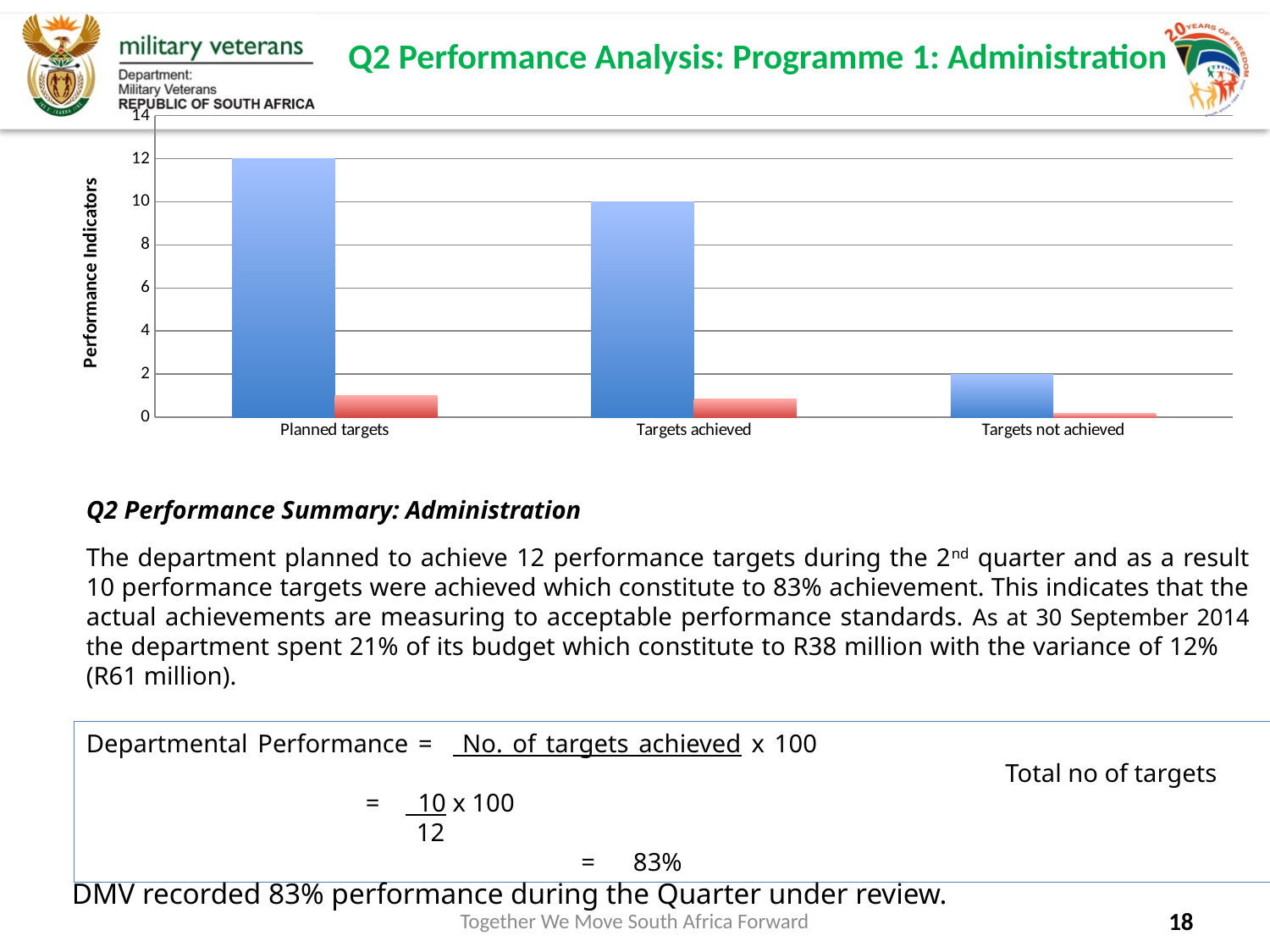
Which is larger, the blue bar for Targets achieved or the blue bar for Targets not achieved? Targets achieved What is the value of the blue bar for Targets not achieved? 2 How many categories are shown on the x axis of the chart? 3 Do the blue bars rise or fall from left to right across the categories? fall Is the red bar for Planned targets greater or less than 2? less What is the value of the blue bar for Targets achieved? 10 What type of chart is shown on the slide? bar chart What is the label on the vertical axis of the chart? Performance Indicators What is the value of the blue bar for Planned targets? 12 What is the difference between the blue bars for Planned targets and Targets achieved? 2 Which category has the highest blue bar? Planned targets Which category has the lowest blue bar? Targets not achieved